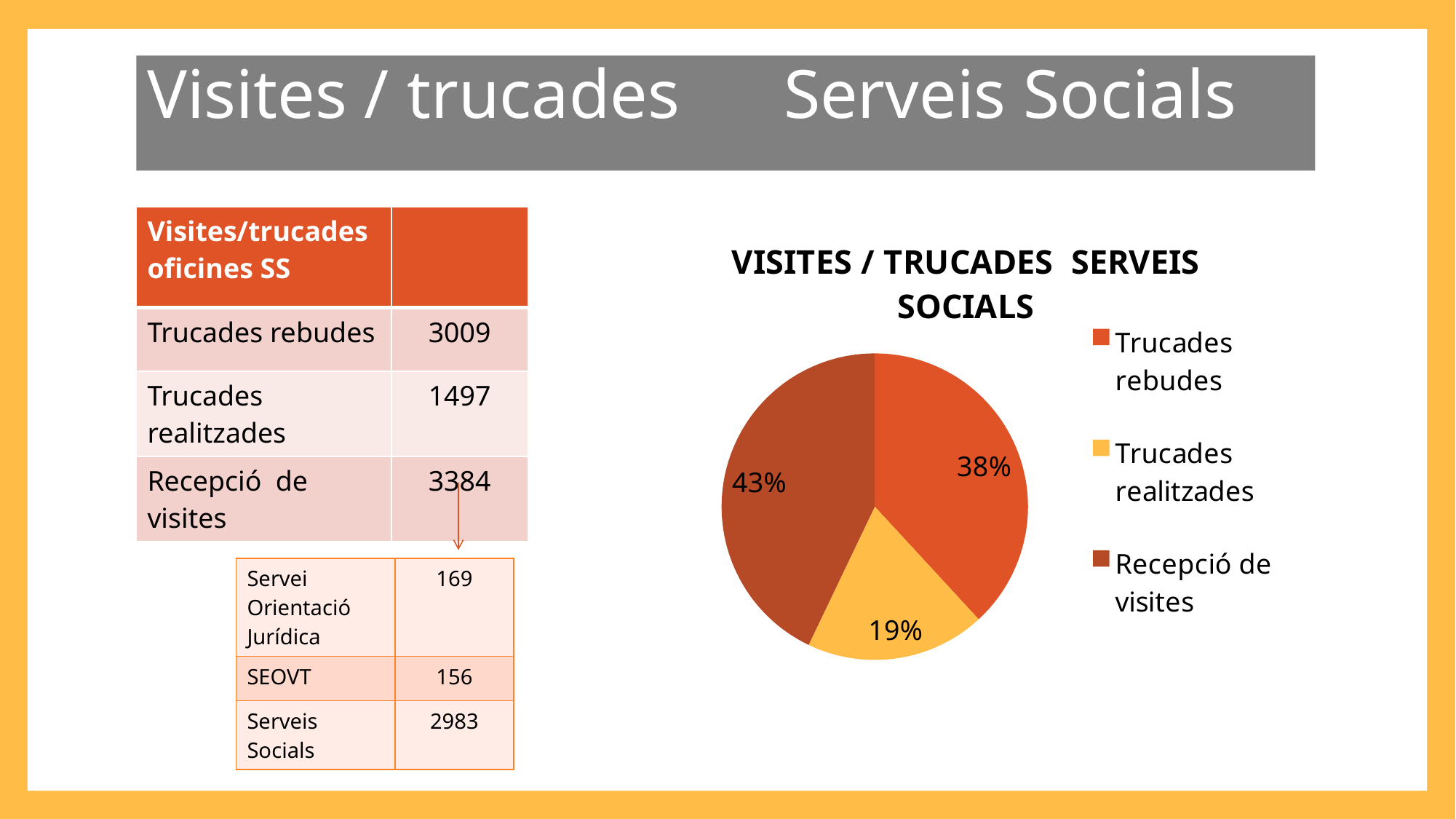
What type of chart is shown on the slide? pie chart Which category has the smallest slice of the pie? Trucades realitzades Which slice is larger, Trucades rebudes or Trucades realitzades? Trucades rebudes What share of the pie does Trucades realitzades represent? 19% Which category has the largest slice of the pie? Recepció de visites What share of the pie does Trucades rebudes represent? 38% How many slices does the pie chart have? 3 How many entries does the legend of the pie chart list? 3 What share of the pie does Recepció de visites represent? 43% Which category is shown in yellow in the pie chart? Trucades realitzades What is the title of the pie chart? VISITES / TRUCADES SERVEIS SOCIALS What is the difference in percentage points between the Recepció de visites slice and the Trucades realitzades slice? 24